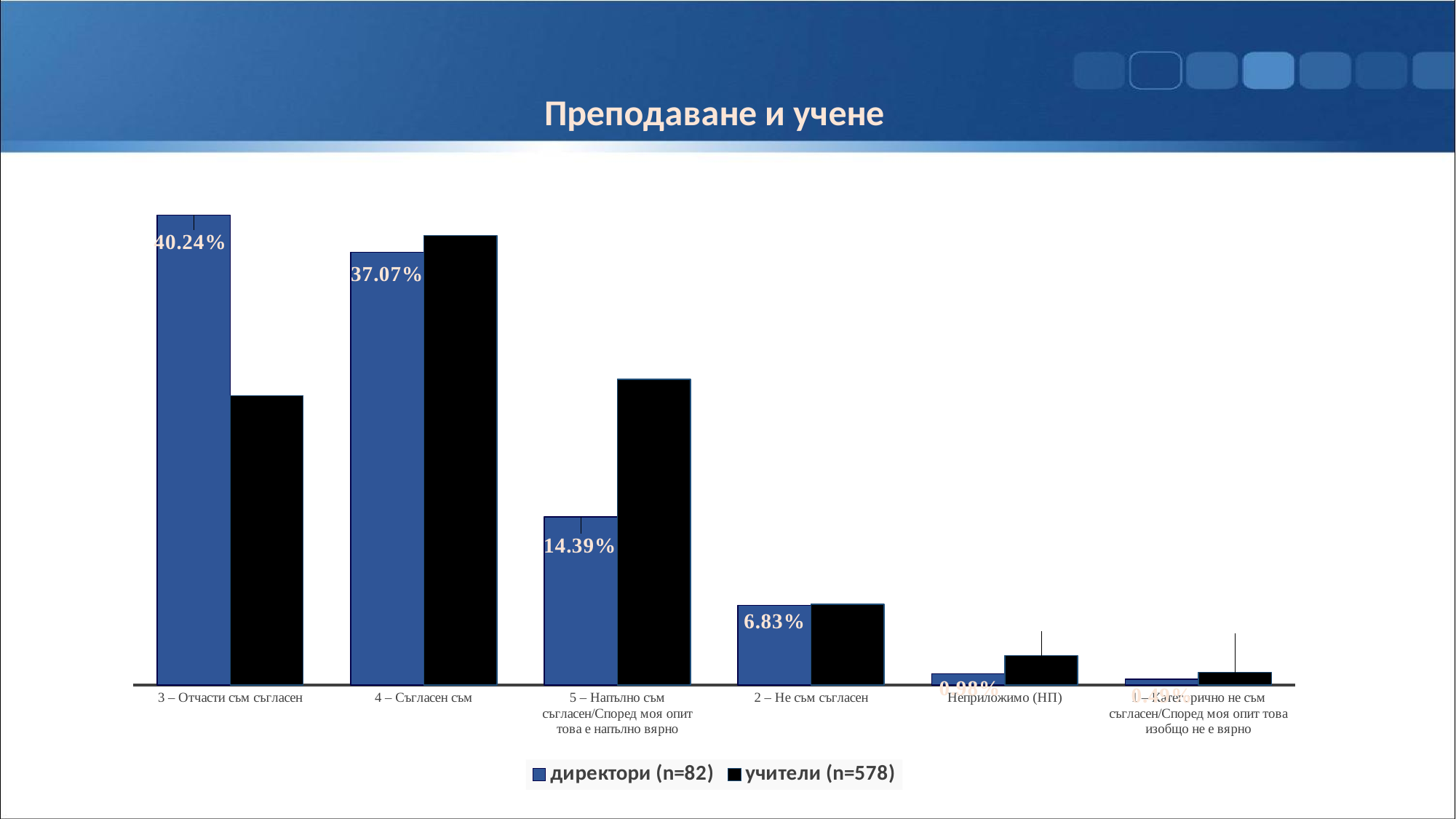
What is the value for директори (n=82) in the category "2 – Не съм съгласен"? 6.83% How many categories are shown on the x axis? 6 What is the value for директори (n=82) in the category "5 – Напълно съм съгласен/Според моя опит това е напълно вярно"? 14.39% What is the value for директори (n=82) in the category "4 – Съгласен съм"? 37.07% In the category "5 – Напълно съм съгласен/Според моя опит това е напълно вярно", which series has the larger value, директори (n=82) or учители (n=578)? учители (n=578) What kind of chart is shown on the slide? bar chart What is the difference between the директори (n=82) values for "3 – Отчасти съм съгласен" and "4 – Съгласен съм"? 3.17% How many series does the legend list? 2 What is the value for директори (n=82) in the category "3 – Отчасти съм съгласен"? 40.24% Which category has the highest value for учители (n=578)? 4 – Съгласен съм Which category has the highest value for директори (n=82)? 3 – Отчасти съм съгласен In the category "3 – Отчасти съм съгласен", which series has the larger value, директори (n=82) or учители (n=578)? директори (n=82)